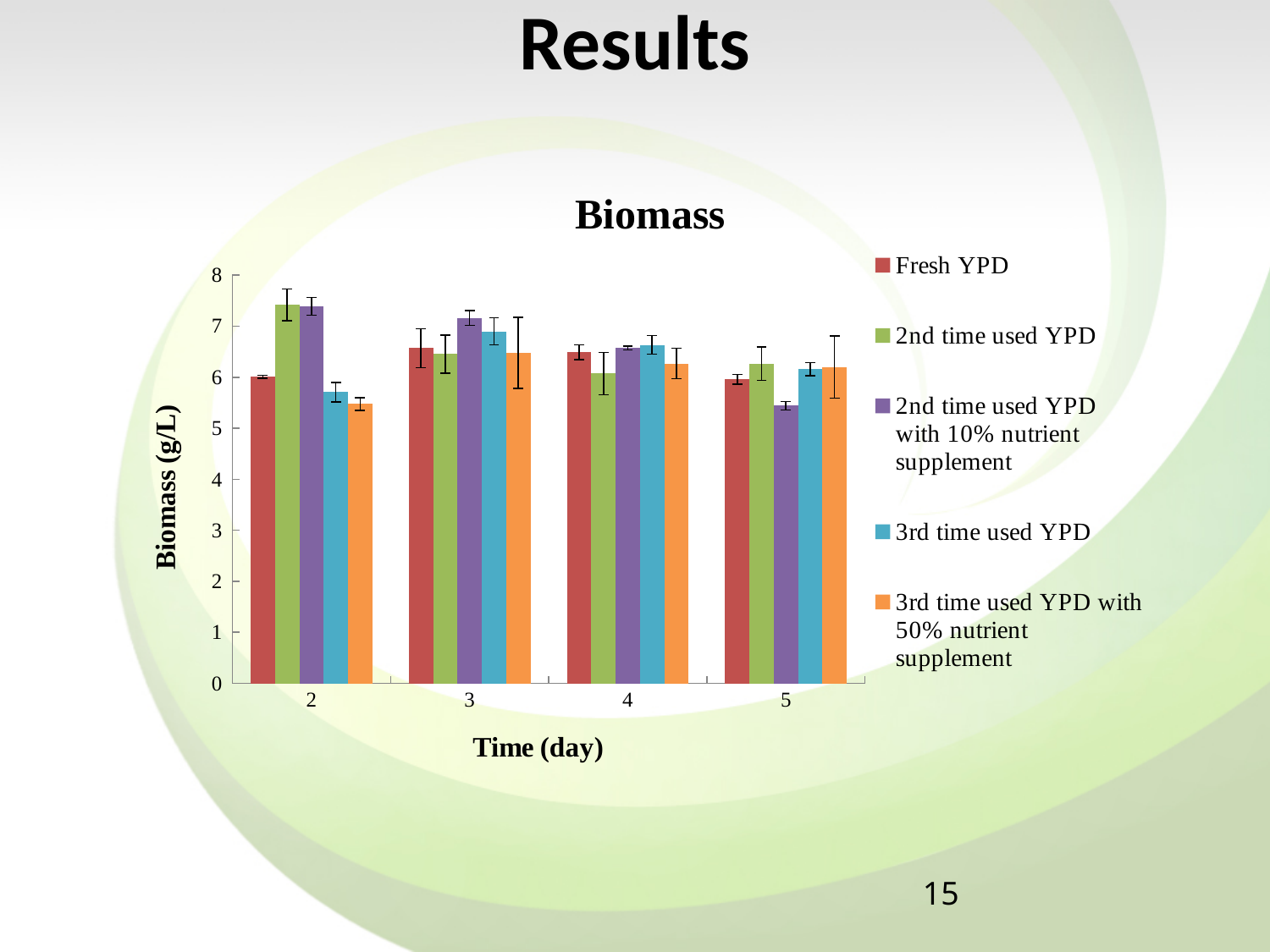
How many time points (days) are shown on the x axis? 4 What is the title of the chart? Biomass What is the label of the y axis? Biomass (g/L) Is the value for 2nd time used YPD at day 2 greater or less than 7? greater Is the value for 3rd time used YPD with 50% nutrient supplement at day 2 greater or less than 6? less Is the value for 2nd time used YPD with 10% nutrient supplement at day 3 greater or less than 7? greater What kind of chart is shown on the slide? bar chart At day 5, which series has the lowest biomass? 2nd time used YPD with 10% nutrient supplement At day 2, which is larger: Fresh YPD or 2nd time used YPD? 2nd time used YPD How many series does the legend list? 5 Does the biomass for 2nd time used YPD with 10% nutrient supplement rise or fall from day 2 to day 5? fall